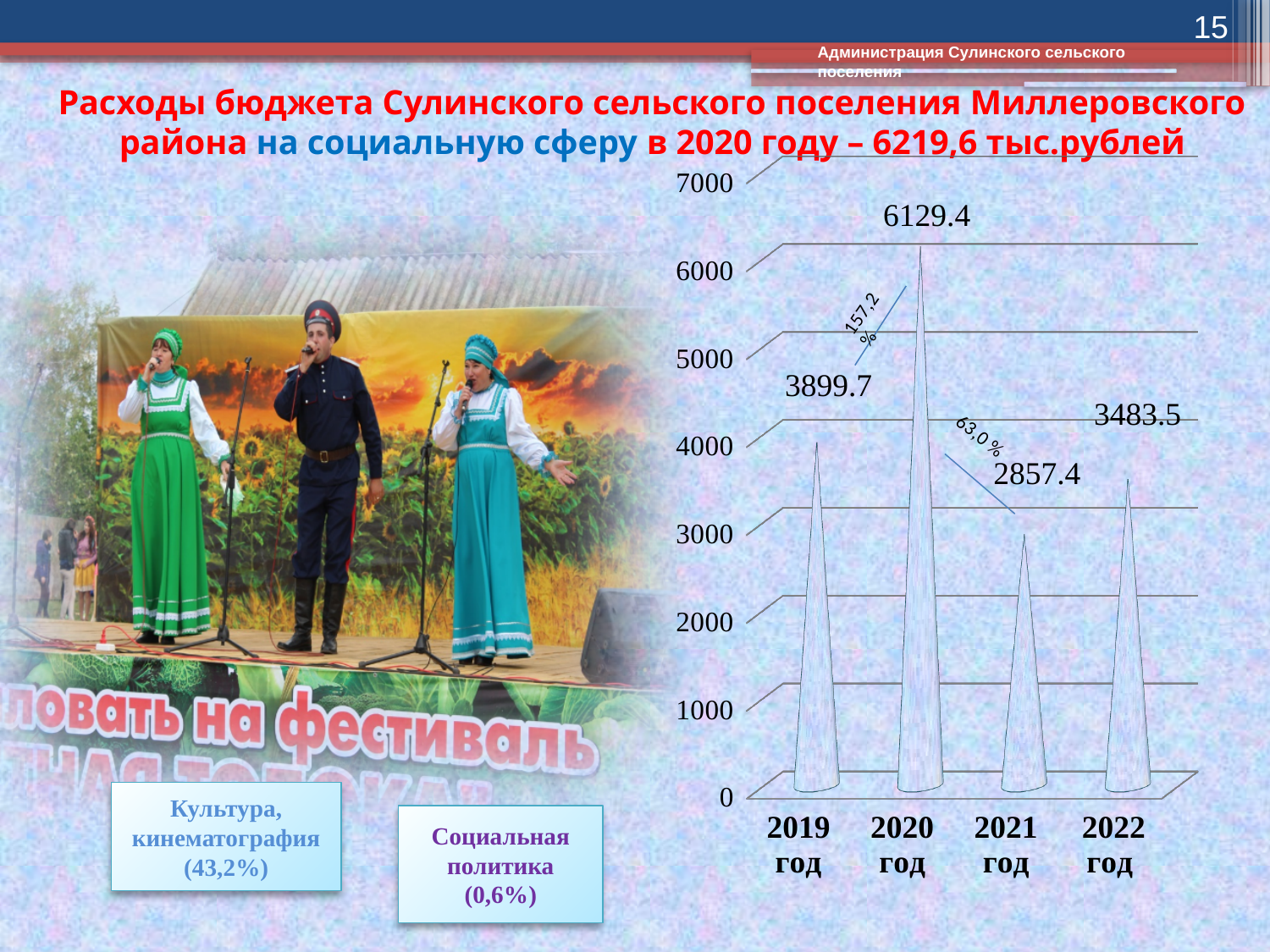
How many years are shown on the x axis? 4 What is the value for 2019 год? 3899.7 What is the value for 2020 год? 6129.4 What kind of chart is shown? bar chart Which year has the highest value? 2020 год Which year has the lowest value? 2021 год What is the difference between the values for 2020 год and 2019 год? 2229.7 What is the value for 2021 год? 2857.4 What is the value for 2022 год? 3483.5 Is the value for 2021 год greater or less than 3000? less Which is larger, the value for 2019 год or 2022 год? 2019 год What percentage label is shown between the 2019 год and 2020 год bars? 157,2 %